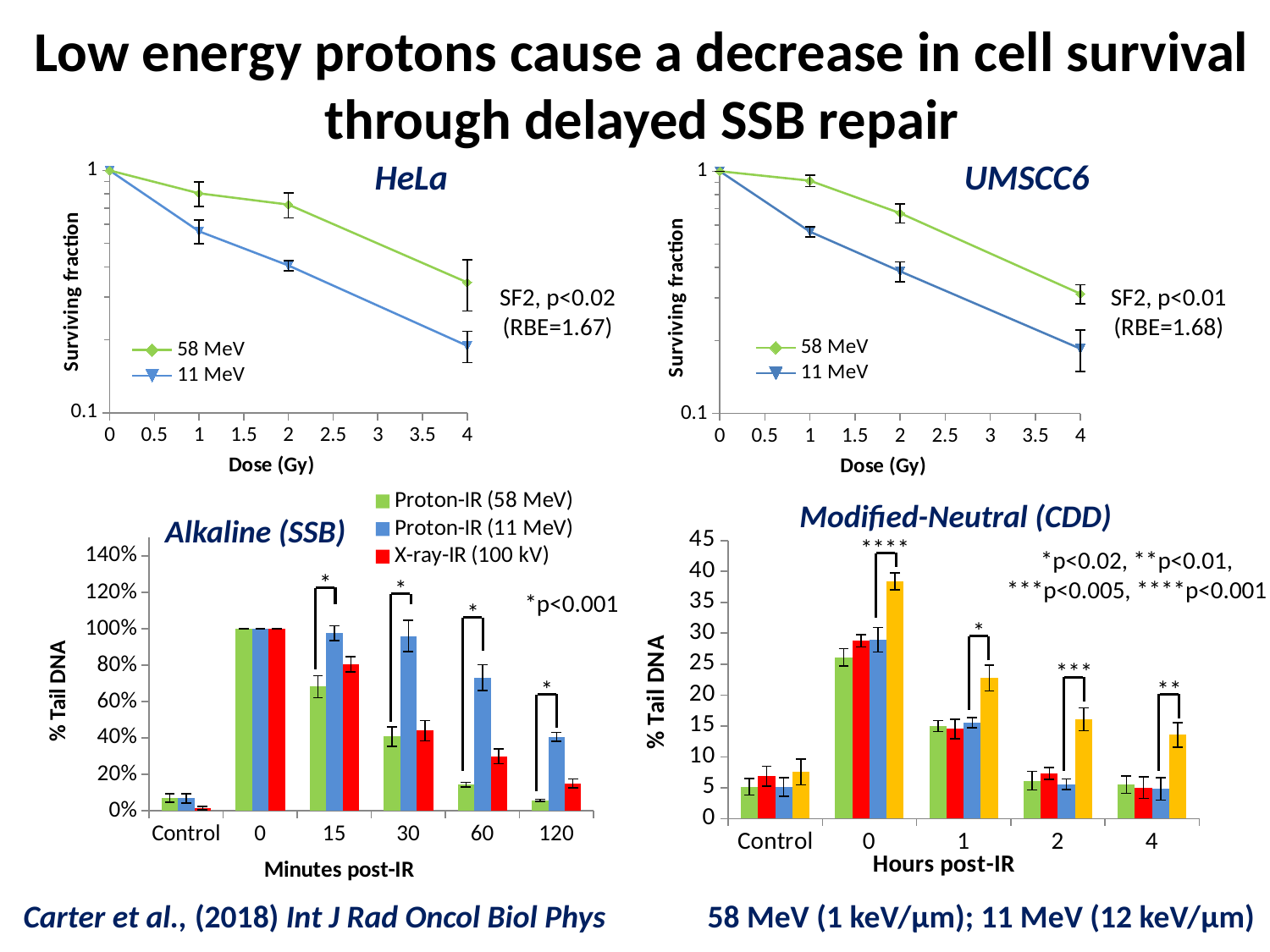
In the Alkaline (SSB) chart, what is the % Tail DNA for Proton-IR (58 MeV) at 0 minutes post-IR? 100% What kind of chart is the Alkaline (SSB) chart at the bottom left of the slide? bar chart In the UMSCC6 chart, does the surviving fraction for 11 MeV rise or fall as the dose increases? fall In the Alkaline (SSB) chart, how many categories are shown on the x axis? 6 In the Alkaline (SSB) chart, at 60 minutes post-IR, which is larger: Proton-IR (58 MeV) or Proton-IR (11 MeV)? Proton-IR (11 MeV) What kind of chart is the HeLa chart at the top left of the slide? line chart In the Modified-Neutral (CDD) chart, how many categories are shown on the x axis? 5 In the Alkaline (SSB) chart, how many series does the legend list? 3 In the Alkaline (SSB) chart, is the value for Proton-IR (11 MeV) at 15 minutes post-IR greater or less than 80%? greater In the Modified-Neutral (CDD) chart, is the value of the yellow bar at 0 hours post-IR greater or less than 35? greater In the HeLa chart, what is the surviving fraction for 58 MeV at a dose of 0 Gy? 1 In the HeLa chart, how many series does the legend list? 2